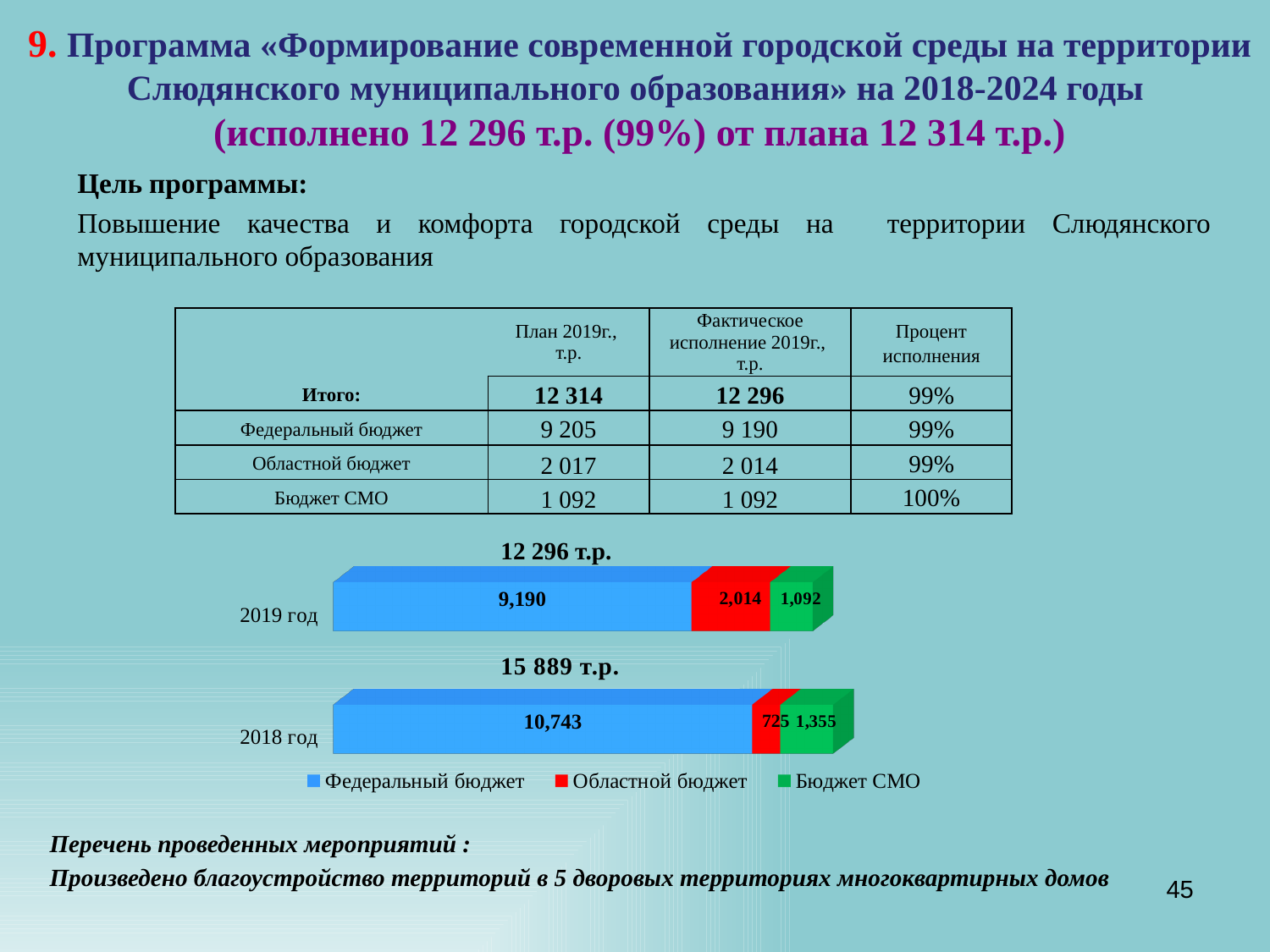
What is the value of Областной бюджет for 2018 год in the chart? 725 What is the total of the stacked bar for 2019 год? 12 296 т.р. What is the value of Федеральный бюджет for 2018 год in the chart? 10,743 Which year has the larger Федеральный бюджет value, 2018 год or 2019 год? 2018 год What kind of chart is shown on the slide? stacked bar chart What is the difference between the Областной бюджет values for 2019 год and 2018 год? 1,289 Which colour represents Бюджет СМО in the chart legend? green How many categories (years) are plotted in the chart? 2 What is the value of Федеральный бюджет for 2019 год in the chart? 9,190 How many series does the chart legend list? 3 What is the value of Бюджет СМО for 2019 год in the chart? 1,092